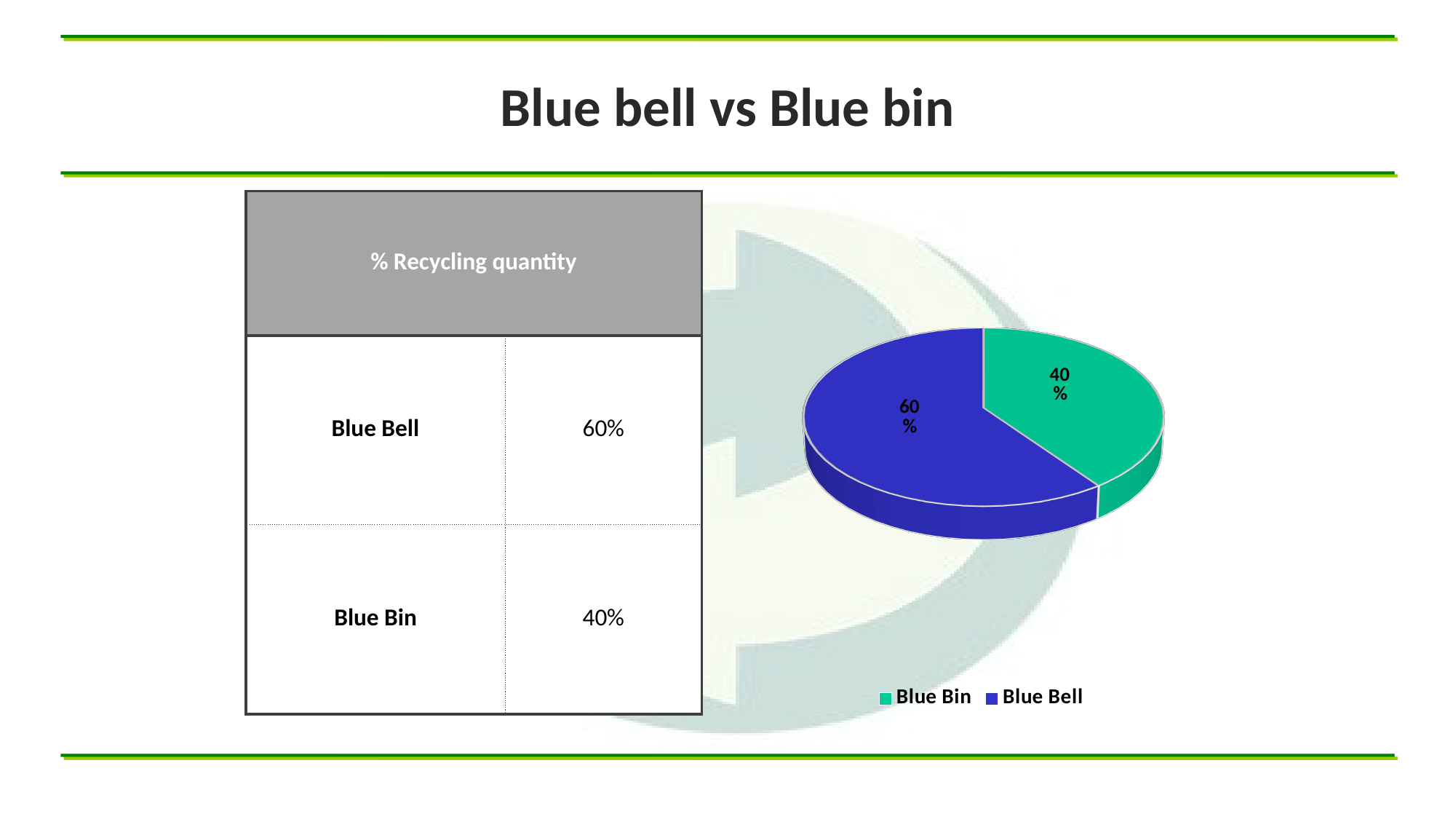
Which is larger, the Blue Bin slice or the Blue Bell slice? Blue Bell How many entries does the legend list? 2 Which slice of the pie is the largest? Blue Bell What colour is the Blue Bin slice in the pie chart? Green What share of the pie does Blue Bin have? 40% Which slice of the pie is the smallest? Blue Bin What is the difference between the Blue Bell and Blue Bin shares? 20% What share of the pie does Blue Bell have? 60% What kind of chart is shown on the slide? Pie chart What colour is the Blue Bell slice in the pie chart? Blue How many slices does the pie chart have? 2